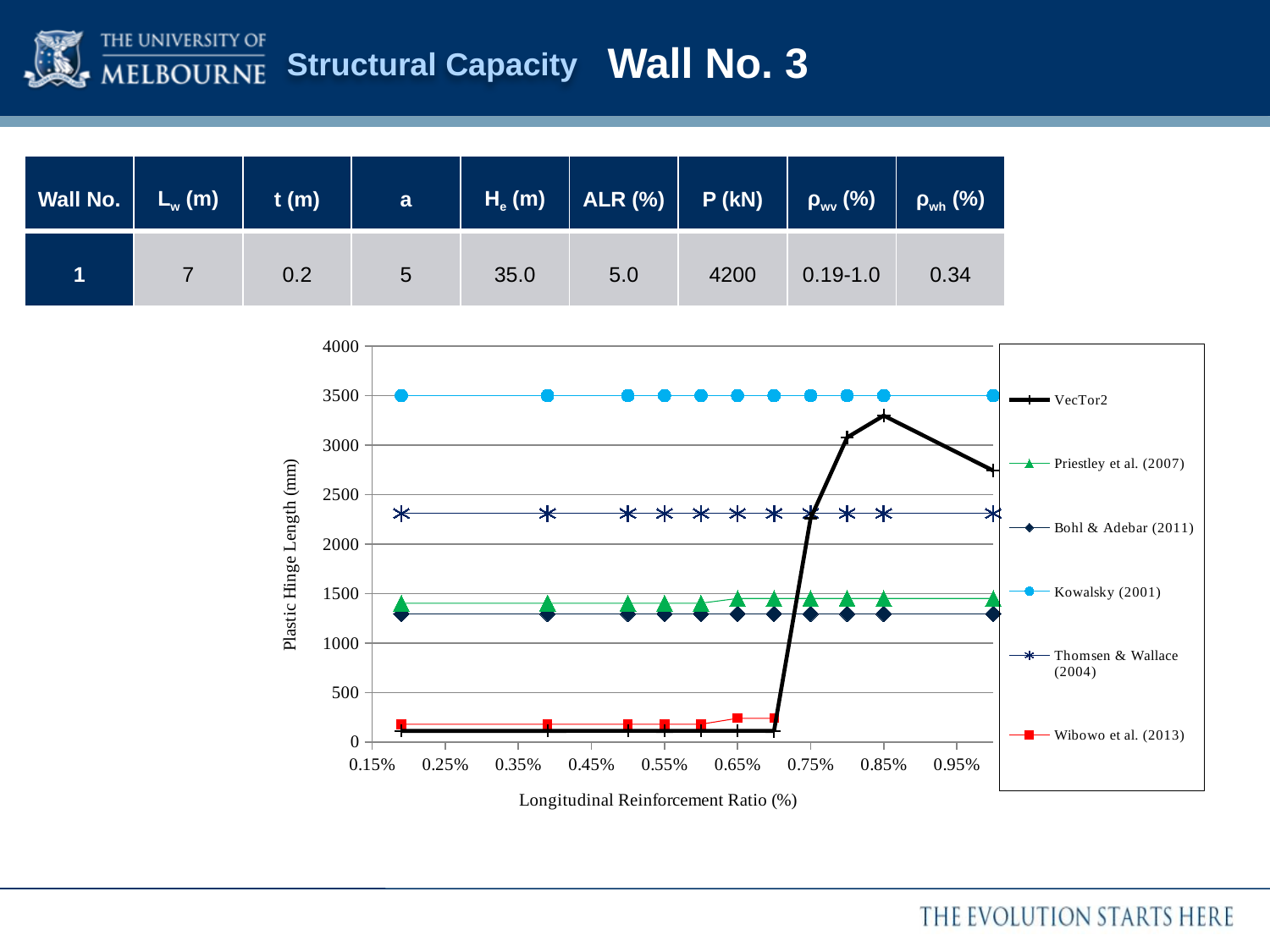
What kind of chart is shown on the slide? line chart Is the value for Bohl & Adebar (2011) greater or less than 1500? less Is the value for Thomsen & Wallace (2004) greater or less than 2000? greater Is the VecTor2 value at 0.25% greater or less than 500? less What plastic hinge length does the Kowalsky (2001) series show across the reinforcement ratios? 3500 What is the title of the y axis? Plastic Hinge Length (mm) What is the title of the x axis? Longitudinal Reinforcement Ratio (%) Which series has the highest plastic hinge length across the plotted range? Kowalsky (2001) How many series does the chart legend list? 6 Which is larger, the Thomsen & Wallace (2004) value or the Priestley et al. (2007) value? Thomsen & Wallace (2004) Does the VecTor2 series rise or fall between 0.85% and the last plotted point? fall